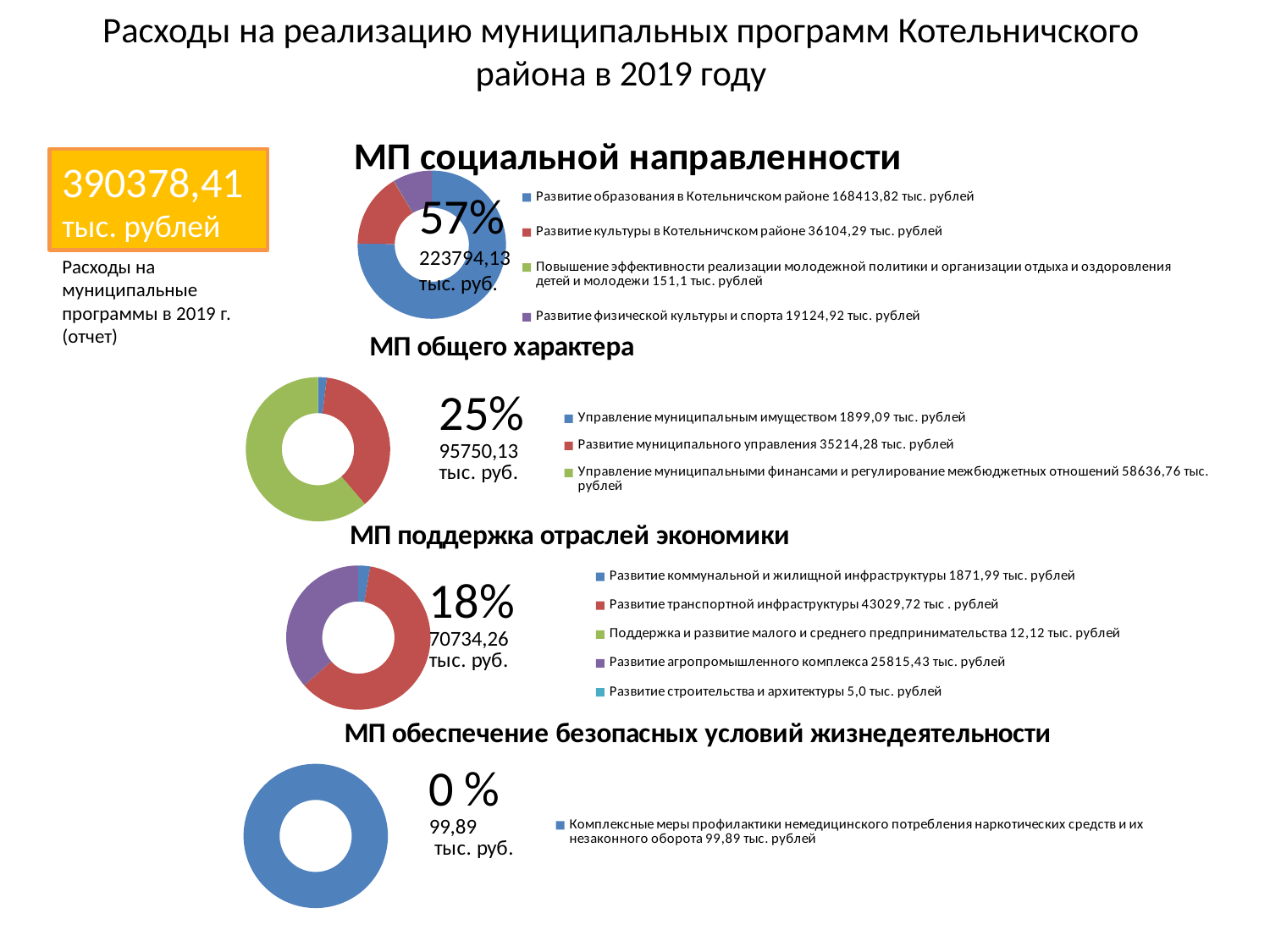
What type of chart is used for 'МП общего характера'? Donut (pie) chart On the chart 'МП обеспечение безопасных условий жизнедеятельности', what is the value for 'Комплексные меры профилактики немедицинского потребления наркотических средств и их незаконного оборота'? 99,89 тыс. рублей On the chart 'МП поддержка отраслей экономики', which category has the largest value? Развитие транспортной инфраструктуры On the chart 'МП поддержка отраслей экономики', which is larger: 'Развитие агропромышленного комплекса' or 'Развитие коммунальной и жилищной инфраструктуры'? Развитие агропромышленного комплекса On the chart 'МП общего характера', what is the difference between 'Управление муниципальными финансами и регулирование межбюджетных отношений' and 'Развитие муниципального управления'? 23422,48 тыс. рублей On the chart 'МП социальной направленности', which category has the largest value? Развитие образования в Котельничском районе On the chart 'МП социальной направленности', which category has the smallest value? Повышение эффективности реализации молодежной политики и организации отдыха и оздоровления детей и молодежи On the chart 'МП общего характера', how many categories does the legend list? 3 On the chart 'МП поддержка отраслей экономики', how many categories does the legend list? 5 On the chart 'МП социальной направленности', what is the value for 'Развитие образования в Котельничском районе'? 168413,82 тыс. рублей On the chart 'МП общего характера', what is the value for 'Развитие муниципального управления'? 35214,28 тыс. рублей On the chart 'МП социальной направленности', what percentage is shown in the centre of the donut? 57%